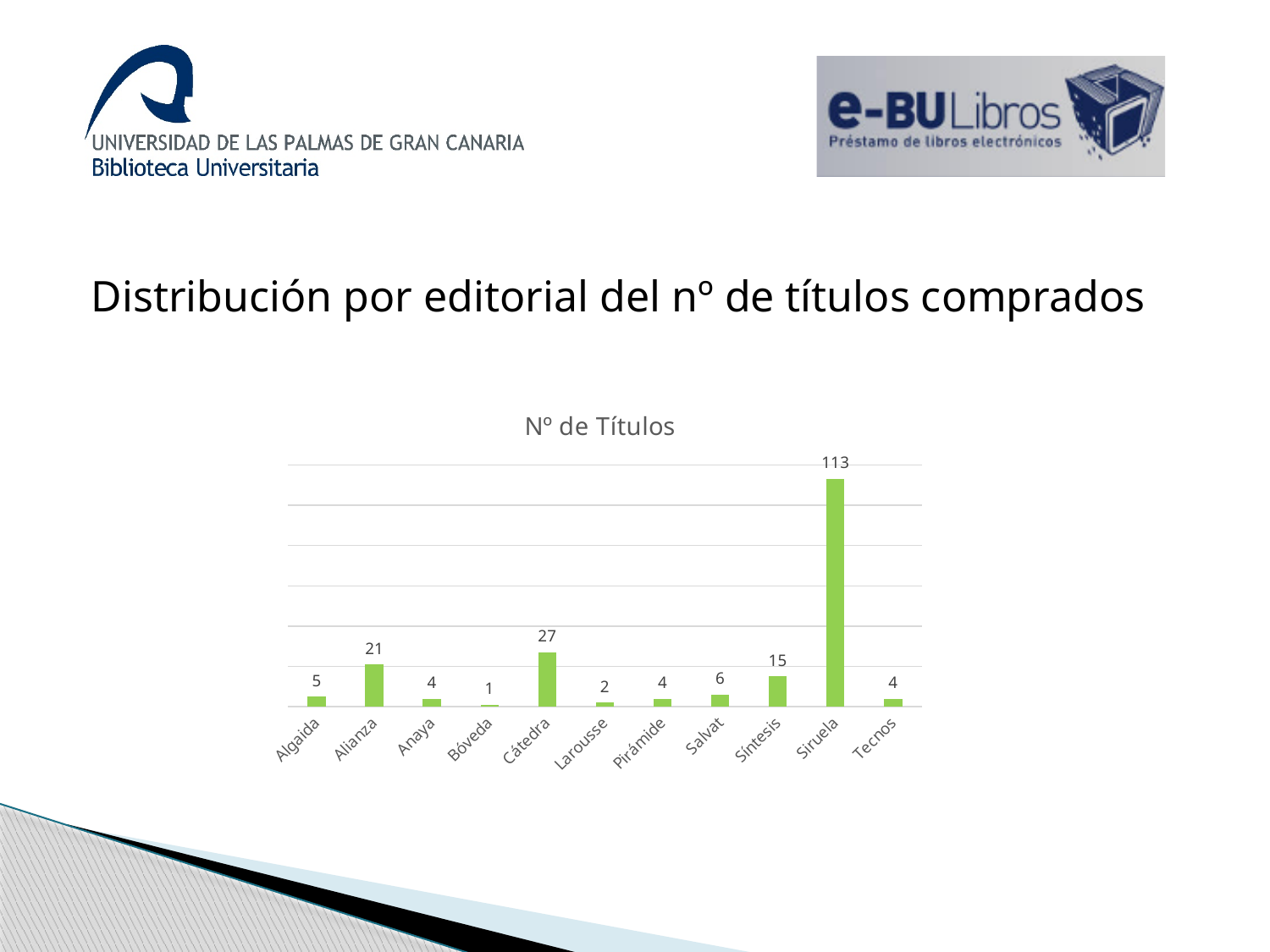
What is the value for Siruela? 113 What is the title of the chart? Nº de Títulos What is the difference between the values for Siruela and Cátedra? 86 Which is larger, the value for Alianza or the value for Salvat? Alianza What is the value for Cátedra? 27 Which publisher has the highest number of titles? Siruela What is the value for Síntesis? 15 Which publisher has the lowest number of titles? Bóveda What is the difference between the values for Alianza and Síntesis? 6 What kind of chart is shown on the slide? Bar chart How many publishers are shown on the x axis? 11 What colour are the bars in the chart? Green